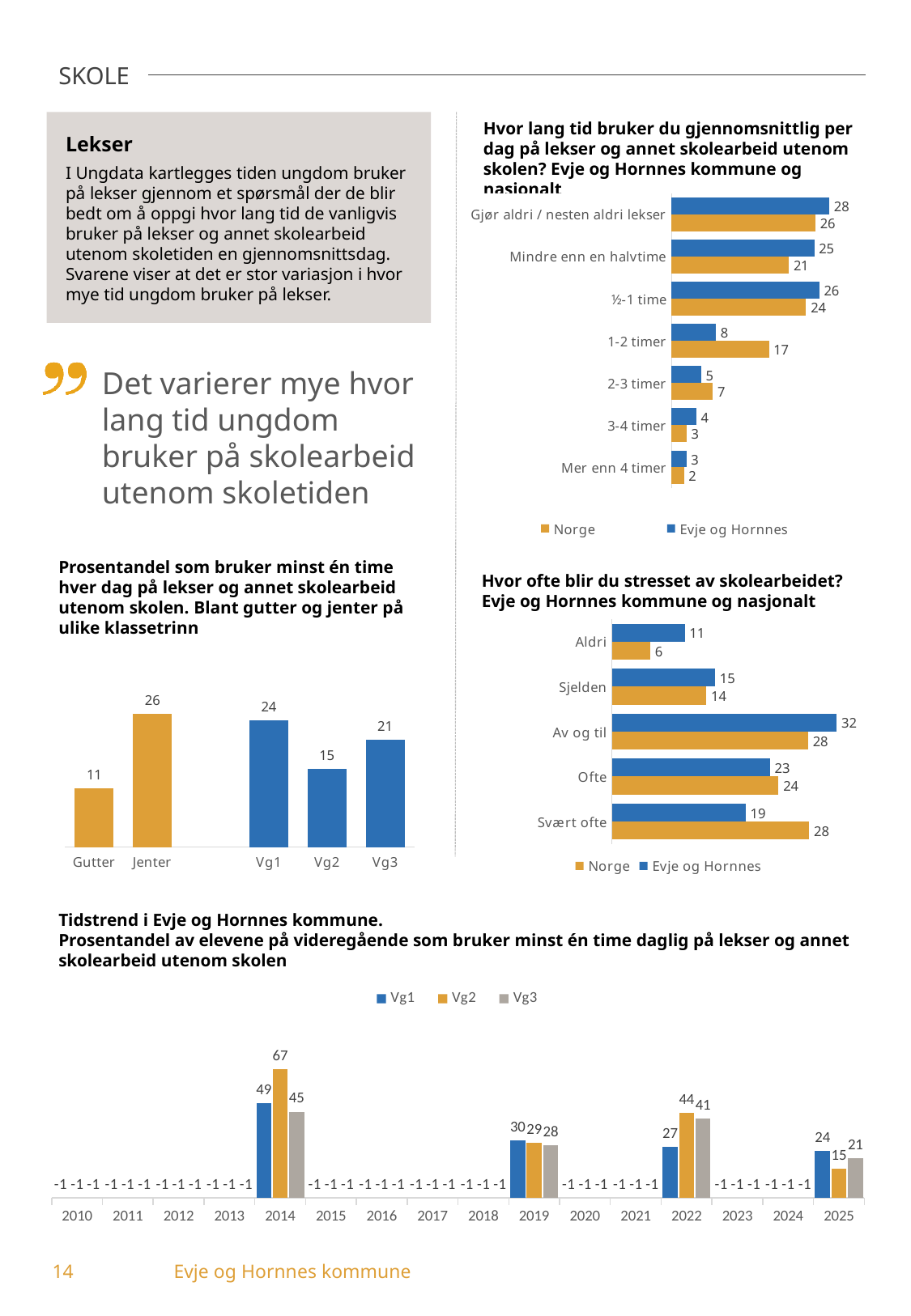
In the chart 'Tidstrend i Evje og Hornnes kommune', what is the difference between Vg1 in 2014 and Vg1 in 2025? 25 In the chart 'Tidstrend i Evje og Hornnes kommune', what is the value for Vg2 in 2014? 67 In the chart 'Prosentandel som bruker minst én time hver dag på lekser og annet skolearbeid utenom skolen', what is the value for Vg2? 15 In the chart 'Hvor ofte blir du stresset av skolearbeidet?', which is larger for 'Aldri': Norge or Evje og Hornnes? Evje og Hornnes In the chart 'Hvor ofte blir du stresset av skolearbeidet?', what is the value for Norge for 'Svært ofte'? 28 In the chart 'Hvor ofte blir du stresset av skolearbeidet?', which category has the highest value for Evje og Hornnes? Av og til In the chart 'Hvor lang tid bruker du gjennomsnittlig per dag på lekser og annet skolearbeid utenom skolen?', how many categories are shown? 7 In the chart 'Prosentandel som bruker minst én time hver dag på lekser og annet skolearbeid utenom skolen', what is the difference between Jenter and Gutter? 15 In the chart 'Prosentandel som bruker minst én time hver dag på lekser og annet skolearbeid utenom skolen', which category has the highest value? Jenter In the chart 'Hvor lang tid bruker du gjennomsnittlig per dag på lekser og annet skolearbeid utenom skolen?', what is the value for Evje og Hornnes for '1-2 timer'? 8 In the chart 'Tidstrend i Evje og Hornnes kommune', how many series does the legend list? 3 In the chart 'Hvor lang tid bruker du gjennomsnittlig per dag på lekser og annet skolearbeid utenom skolen?', what is the value for Norge for 'Mindre enn en halvtime'? 21